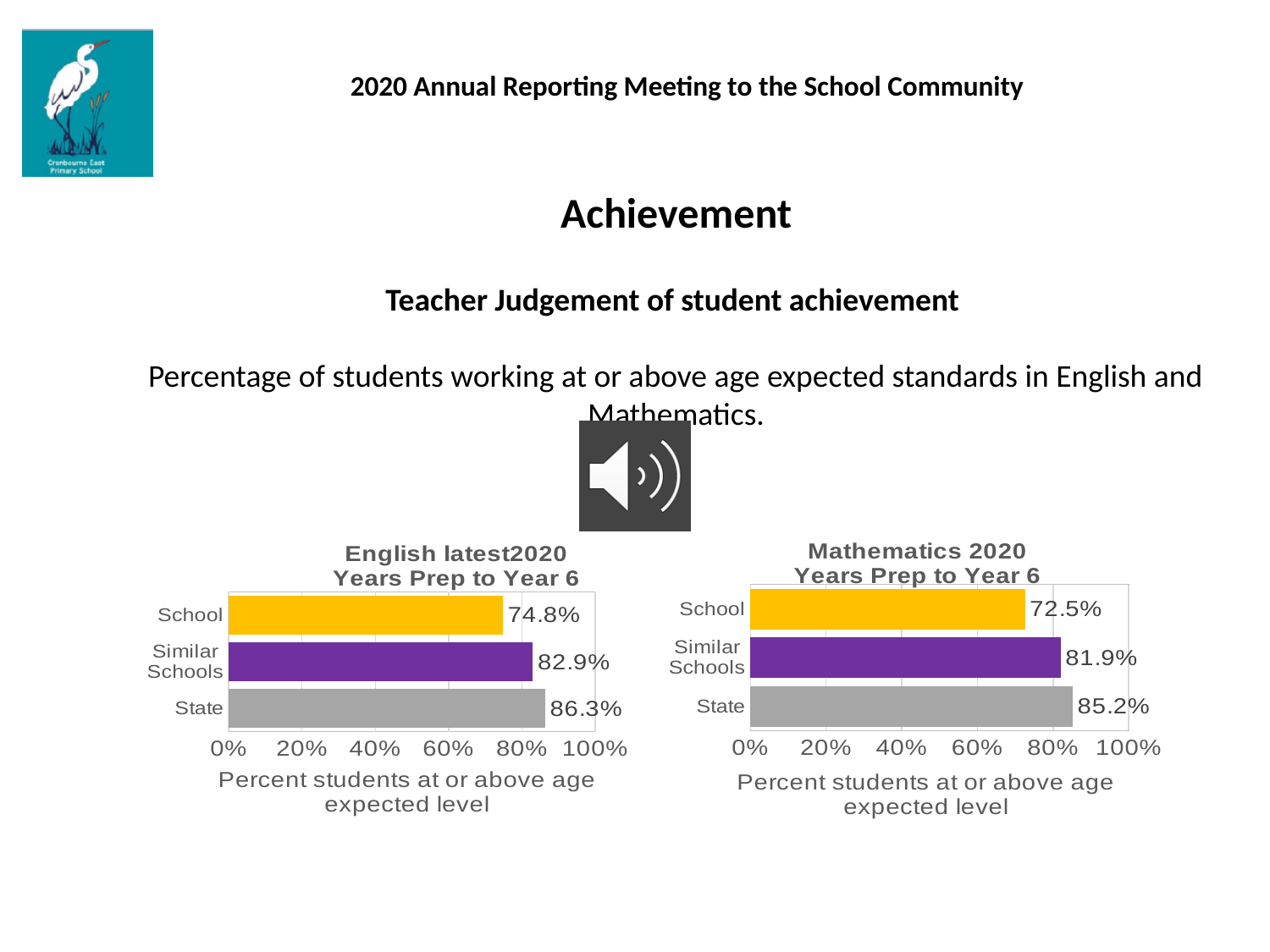
How many categories are shown in the Mathematics 2020 Years Prep to Year 6 chart? 3 In the English latest2020 Years Prep to Year 6 chart, what is the value for School? 74.8% Which is larger: the School value in the English latest2020 chart or the School value in the Mathematics 2020 chart? English latest2020 What is the x-axis label of the Mathematics 2020 Years Prep to Year 6 chart? Percent students at or above age expected level In the English latest2020 Years Prep to Year 6 chart, what is the difference between the State value and the School value? 11.5% In the English latest2020 Years Prep to Year 6 chart, is the value for Similar Schools greater or less than 80%? greater In the Mathematics 2020 Years Prep to Year 6 chart, what is the value for Similar Schools? 81.9% What kind of chart is the English latest2020 Years Prep to Year 6 chart? bar chart In the Mathematics 2020 Years Prep to Year 6 chart, what is the value for State? 85.2% In the English latest2020 Years Prep to Year 6 chart, which category has the highest value? State In the Mathematics 2020 Years Prep to Year 6 chart, which category has the lowest value? School In the Mathematics 2020 Years Prep to Year 6 chart, what is the difference between the Similar Schools value and the School value? 9.4%